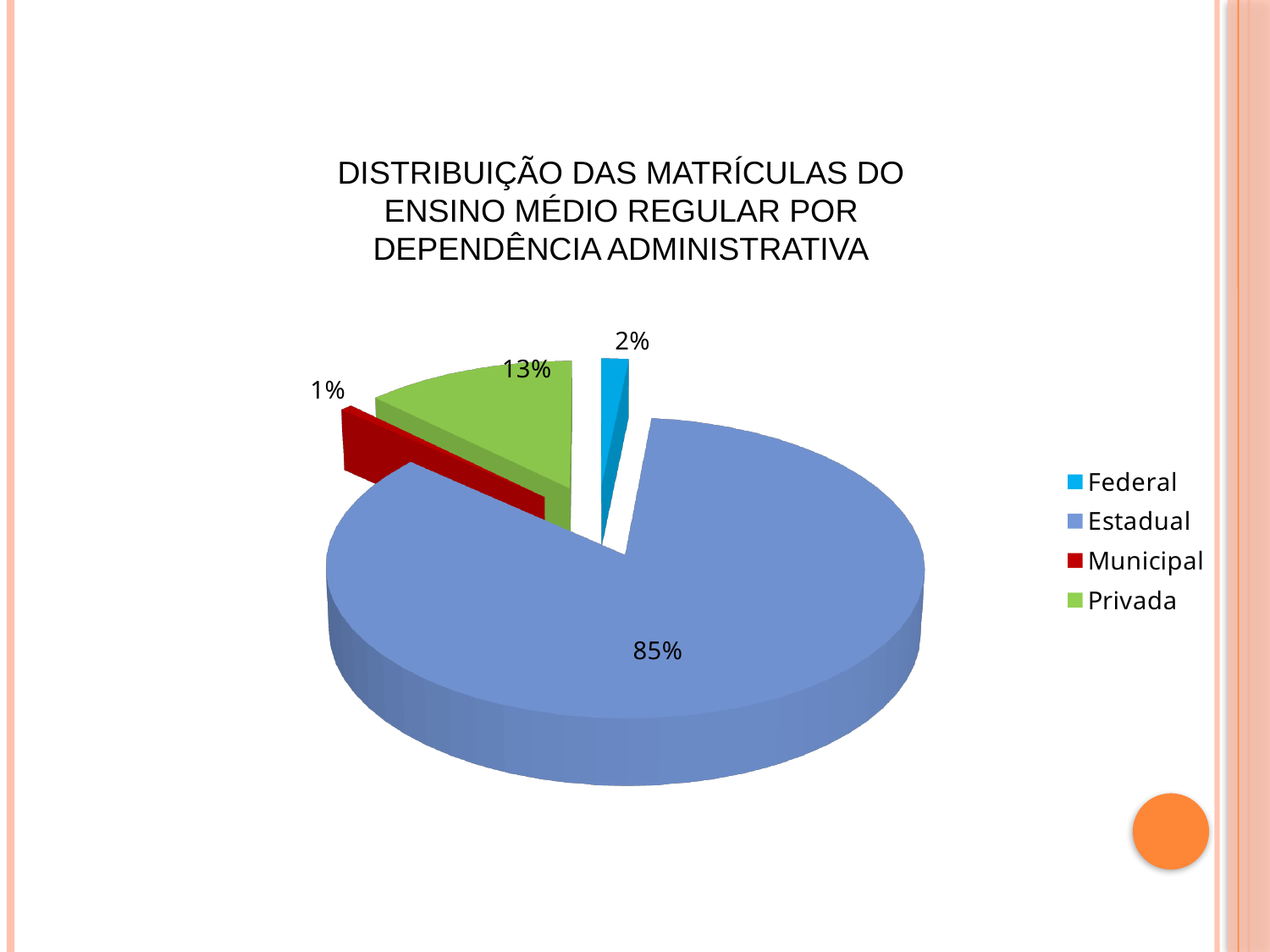
Which is larger, Privada or Federal? Privada What is the difference between the Federal and Municipal shares? 1% How many categories are shown in the pie chart? 4 Which category has the largest slice? Estadual What is the value shown for Privada? 13% Which category has the smallest slice? Municipal Which colour represents Municipal in the legend? Red What kind of chart is shown on the slide? Pie chart What share of the pie does Estadual hold? 85% What is the value shown for Federal? 2% What is the value shown for Municipal? 1% What is the difference between the Estadual and Privada shares? 72%